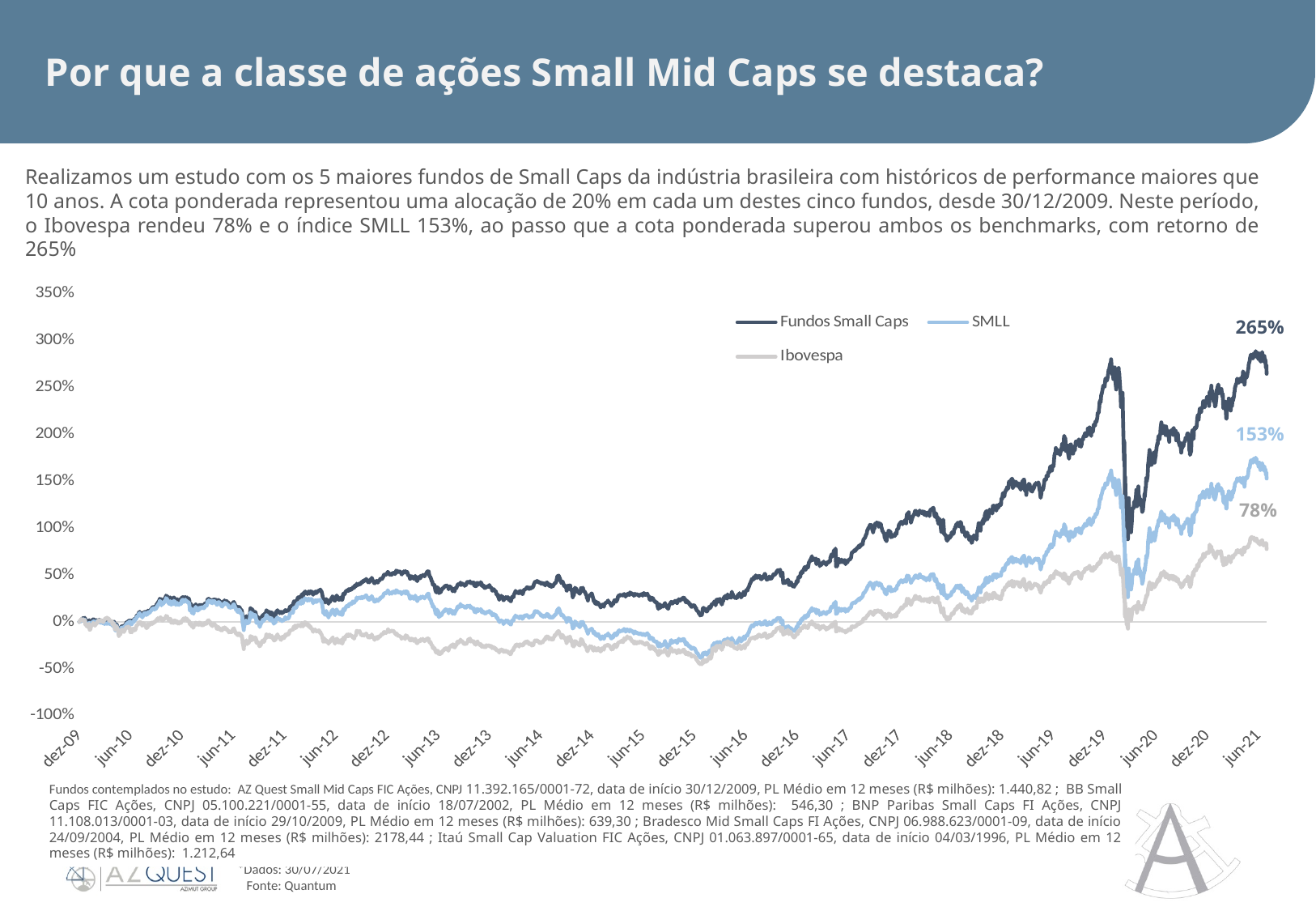
How many series does the chart legend list? 3 Overall, do the Fundos Small Caps values rise or fall from dez-09 to jun-21? rise What is the difference between the final labelled values of Fundos Small Caps and SMLL? 112% What is the final labelled value for the Ibovespa series? 78% Which series is drawn in the lightest grey line? Ibovespa What is the final labelled value for the Fundos Small Caps series? 265% What kind of chart is shown on the slide? line chart What is the final labelled value for the SMLL series? 153% Which series has the larger final labelled value, SMLL or Ibovespa? SMLL Which series ends with the lowest labelled return? Ibovespa What is the difference between the final labelled values of SMLL and Ibovespa? 75% Which series ends with the highest labelled return? Fundos Small Caps